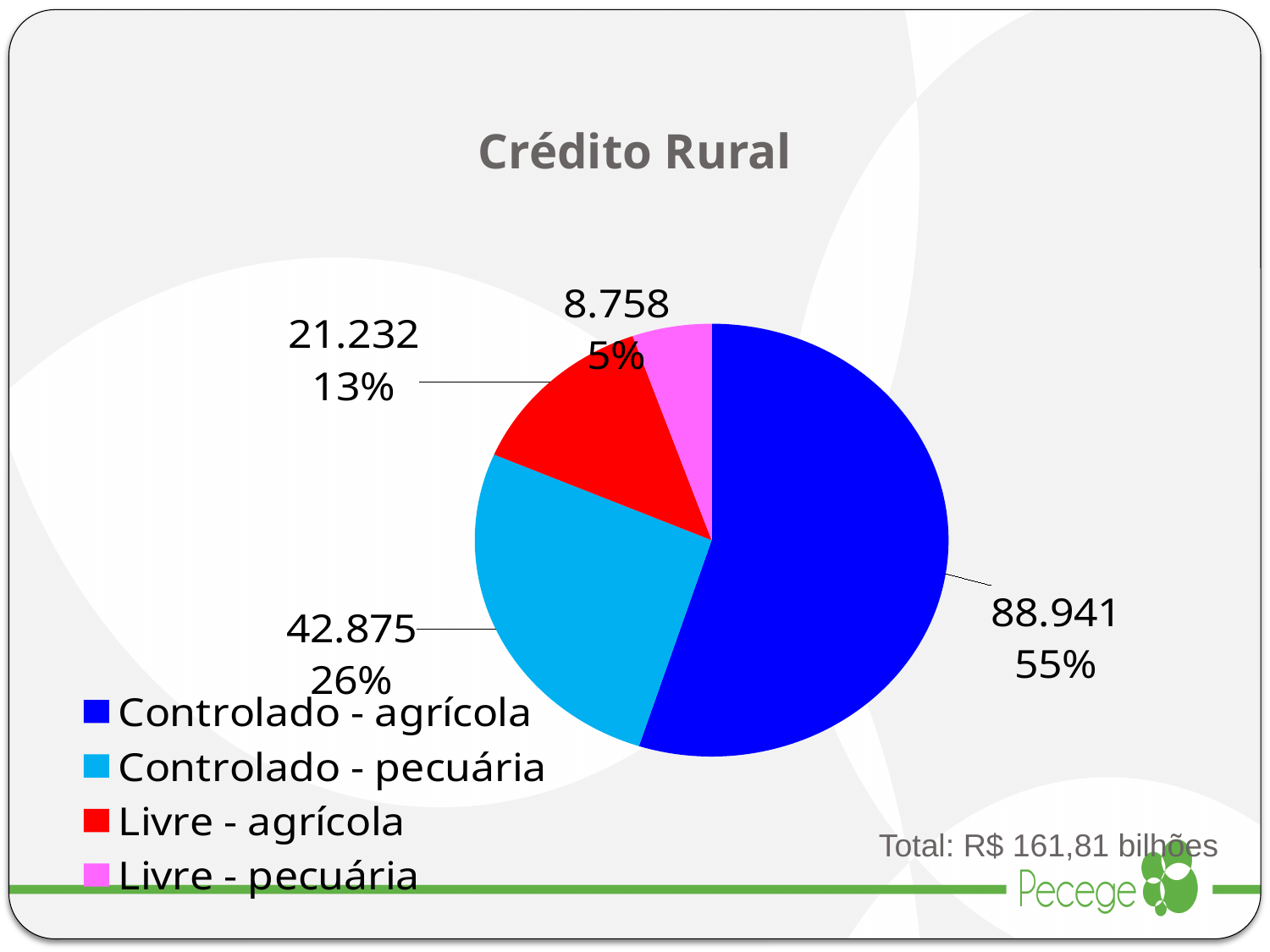
What is the value shown for Controlado - agrícola? 88.941 What is the value shown for Controlado - pecuária? 42.875 What is the value shown for Livre - agrícola? 21.232 What is the title of the chart? Crédito Rural Which category has the smallest slice? Livre - pecuária Which category has the largest slice? Controlado - agrícola How many slices does the pie chart have? 4 What kind of chart is shown on the slide? pie chart What share of the pie does Livre - pecuária represent? 5% What is the value shown for Livre - pecuária? 8.758 How many entries does the legend list? 4 What share of the pie does Controlado - agrícola represent? 55%